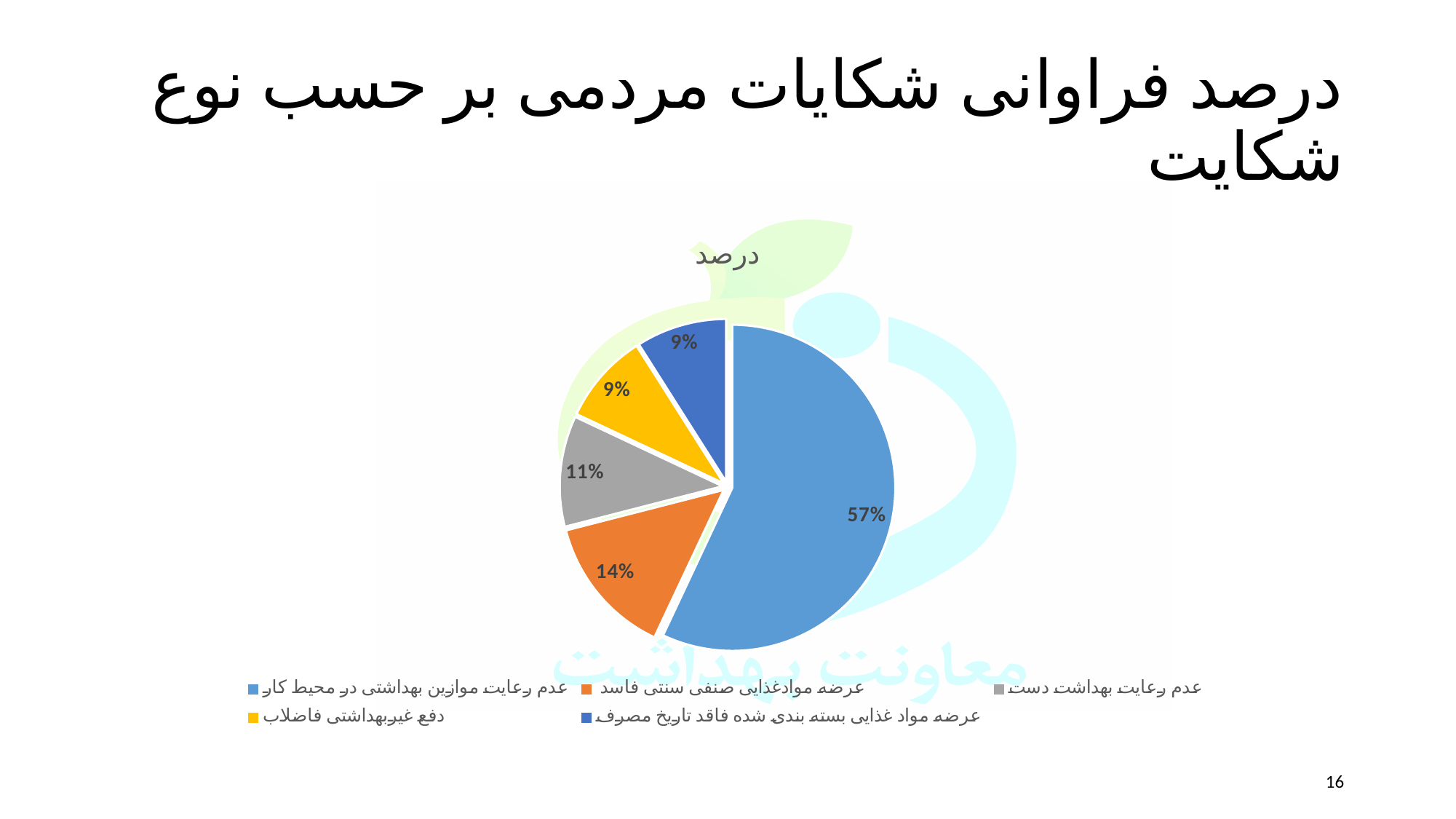
What kind of chart is shown on the slide? pie chart What percentage is shown for the largest slice of the pie chart? 57% What is the title of the chart? درصد What is the share of the gray slice (عدم رعایت بهداشت دست)? 11% What is the share of the orange slice (عرضه موادغذایی صنفی سنتی فاسد)? 14% Which is larger: the orange slice (عرضه موادغذایی صنفی سنتی فاسد) or the gray slice (عدم رعایت بهداشت دست)? the orange slice (عرضه موادغذایی صنفی سنتی فاسد) What is the share of the dark blue slice (عرضه مواد غذایی بسته بندی شده فاقد تاریخ مصرف)? 9% What is the share of the yellow slice (دفع غیربهداشتی فاضلاب)? 9% Which category has the largest share of the pie chart? عدم رعایت موازین بهداشتی در محیط کار What is the difference in percentage points between the largest slice (57%) and the orange slice (14%)? 43 How many slices does the pie chart have? 5 What colour is the slice representing عدم رعایت موازین بهداشتی در محیط کار? blue